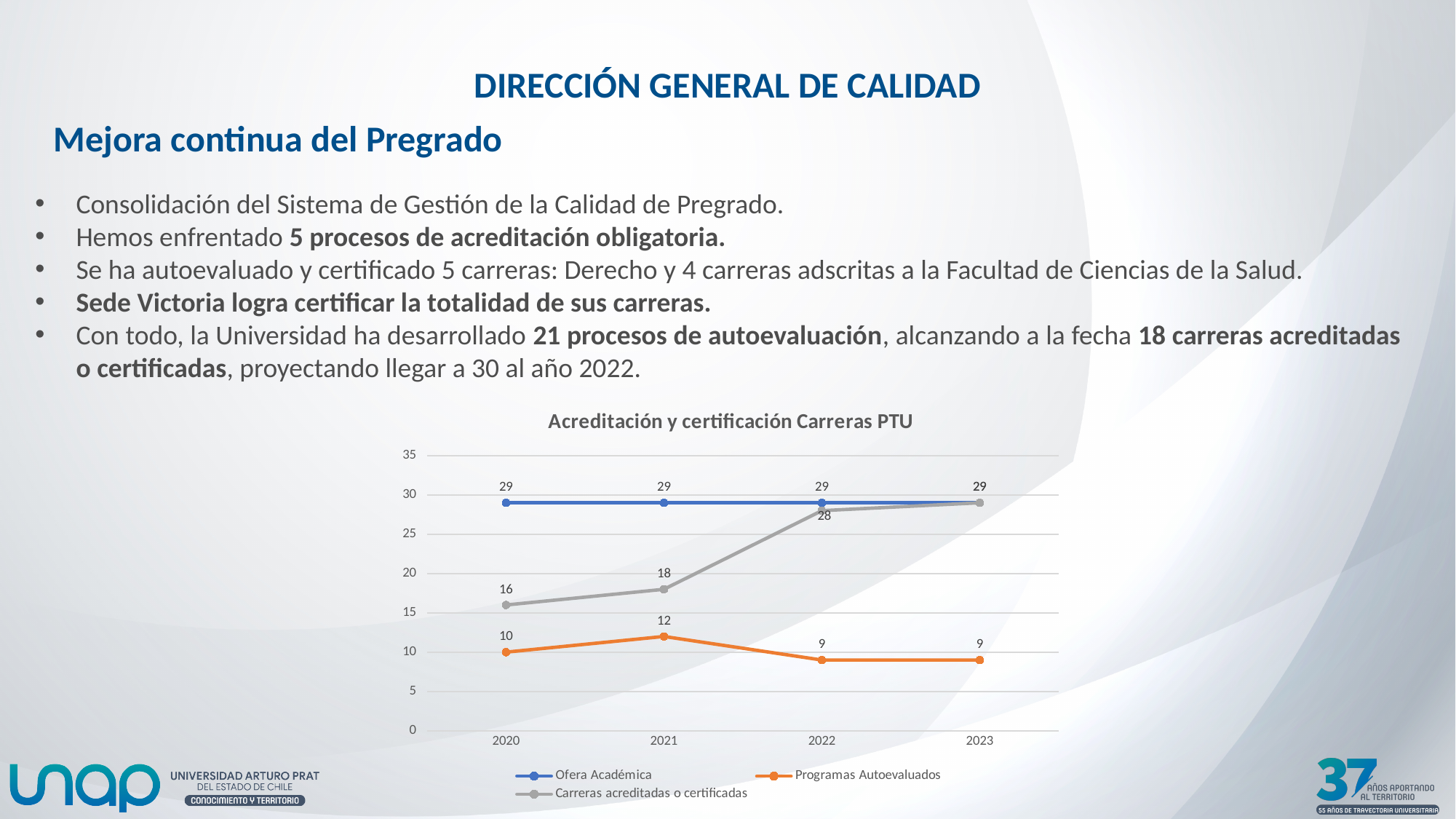
How many series does the chart legend list? 3 What is the value of Ofera Académica in 2023? 29 What is the value of Programas Autoevaluados in 2021? 12 What type of chart is shown on the slide? Line chart What is the title of the chart? Acreditación y certificación Carreras PTU In which year is Carreras acreditadas o certificadas lowest? 2020 What is the value of Carreras acreditadas o certificadas in 2020? 16 In which year is Programas Autoevaluados highest? 2021 How many years are shown on the x axis of the chart? 4 Does the Carreras acreditadas o certificadas series rise or fall from 2020 to 2023? Rise Which is larger in 2022: Carreras acreditadas o certificadas or Programas Autoevaluados? Carreras acreditadas o certificadas What is the difference between Carreras acreditadas o certificadas in 2022 and in 2021? 10